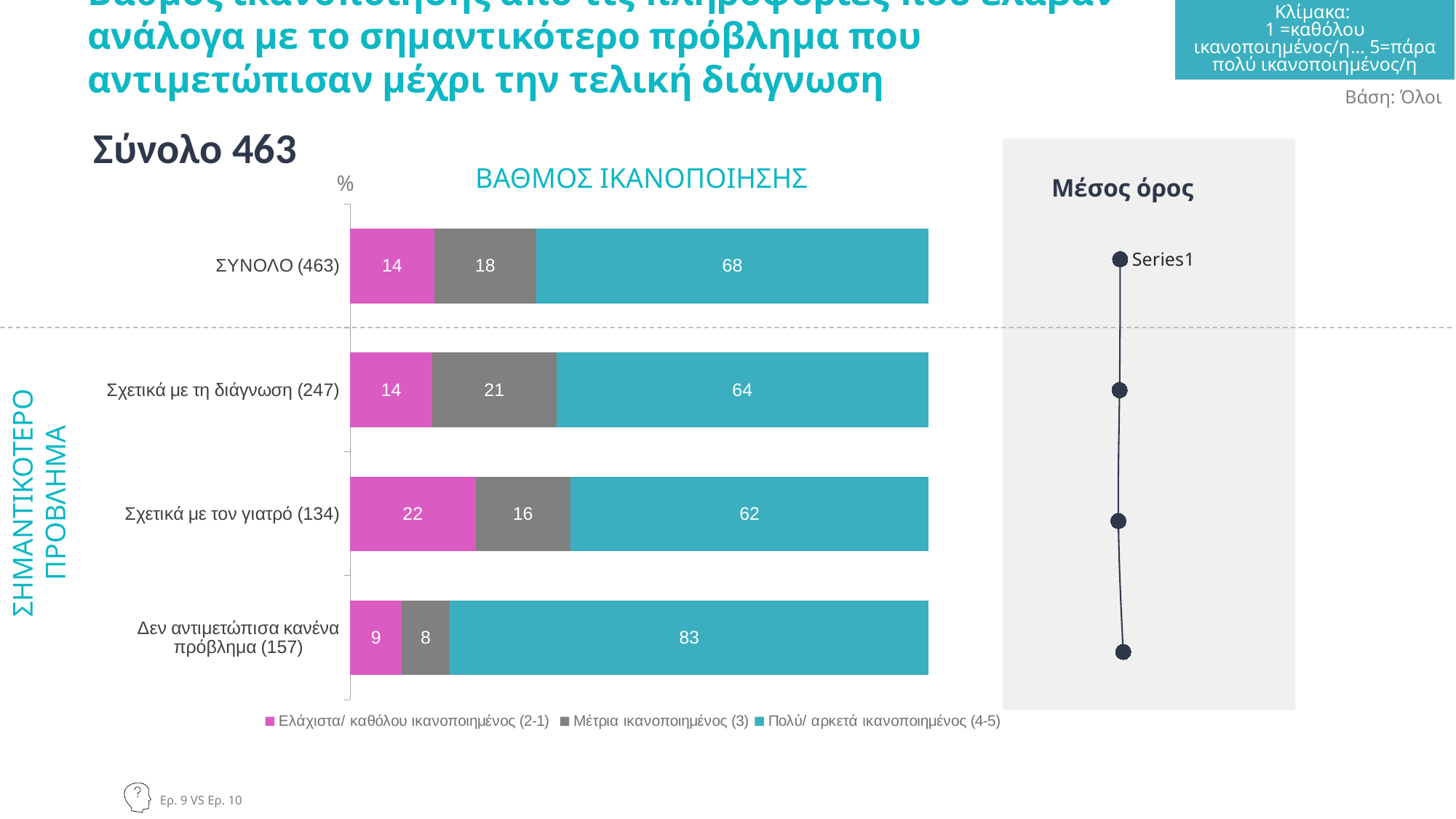
In the stacked bar chart, what is the difference between the 'Πολύ/ αρκετά ικανοποιημένος (4-5)' values for 'Δεν αντιμετώπισα κανένα πρόβλημα (157)' and 'Σχετικά με τον γιατρό (134)'? 21 In the stacked bar chart, what is the value for 'Ελάχιστα/ καθόλου ικανοποιημένος (2-1)' for 'Σχετικά με τον γιατρό (134)'? 22 How many series does the legend of the stacked bar chart list? 3 In the stacked bar chart, which is larger: the 'Μέτρια ικανοποιημένος (3)' value for 'ΣΥΝΟΛΟ (463)' or for 'Σχετικά με τον γιατρό (134)'? ΣΥΝΟΛΟ (463) What kind of chart is the chart titled 'ΒΑΘΜΟΣ ΙΚΑΝΟΠΟΙΗΣΗΣ'? Stacked bar chart In the stacked bar chart, what is the value for 'Πολύ/ αρκετά ικανοποιημένος (4-5)' for 'Δεν αντιμετώπισα κανένα πρόβλημα (157)'? 83 In the stacked bar chart, what is the total of the stacked bar for 'Σχετικά με τη διάγνωση (247)'? 99 In the stacked bar chart, what is the value for 'Μέτρια ικανοποιημένος (3)' for 'Σχετικά με τη διάγνωση (247)'? 21 In the stacked bar chart, which category has the highest value for 'Πολύ/ αρκετά ικανοποιημένος (4-5)'? Δεν αντιμετώπισα κανένα πρόβλημα (157) How many categories does the stacked bar chart show? 4 In the stacked bar chart, what is the value for 'Πολύ/ αρκετά ικανοποιημένος (4-5)' for 'ΣΥΝΟΛΟ (463)'? 68 In the stacked bar chart, which category has the lowest value for 'Ελάχιστα/ καθόλου ικανοποιημένος (2-1)'? Δεν αντιμετώπισα κανένα πρόβλημα (157)